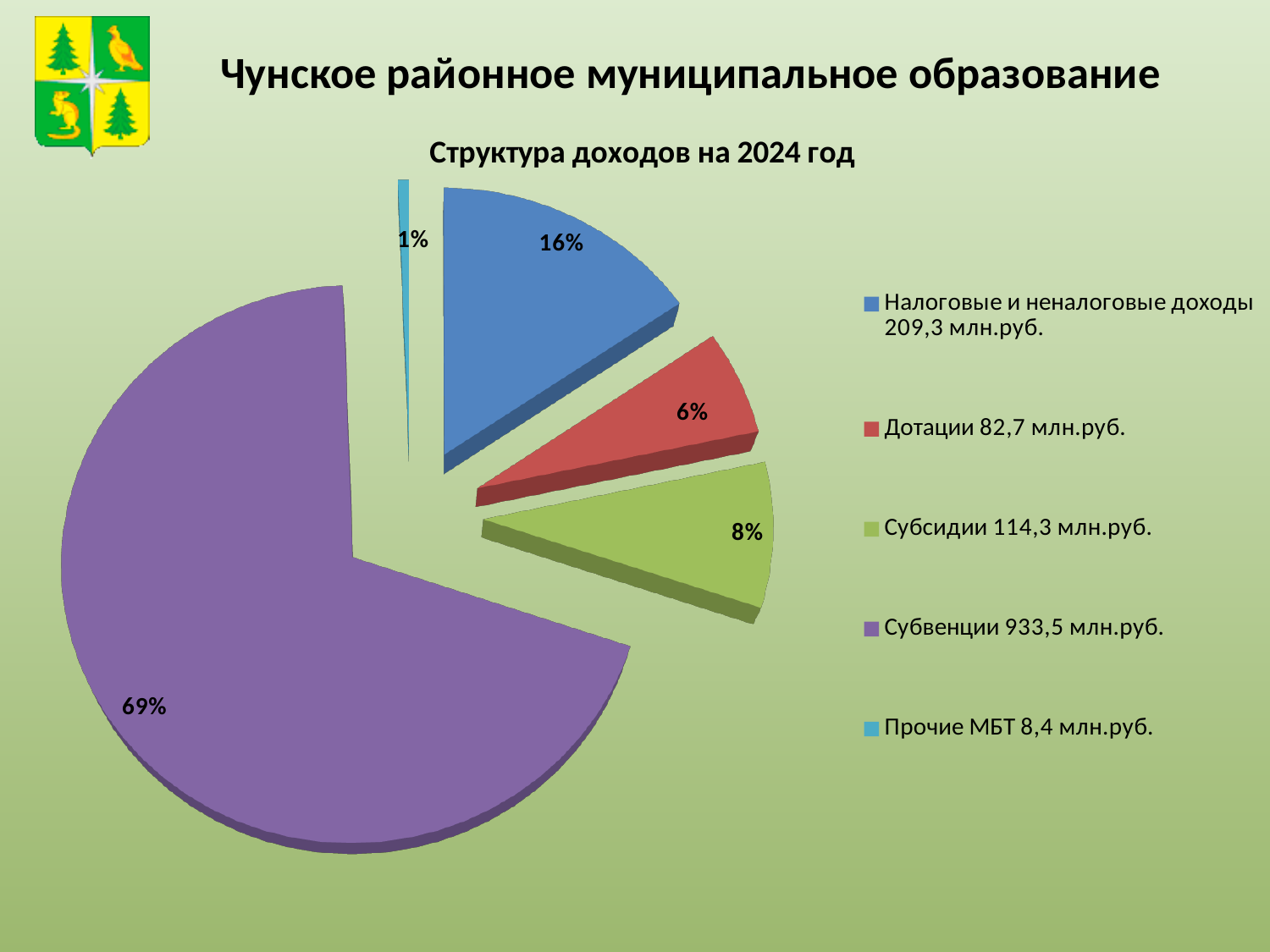
What share of the pie does Налоговые и неналоговые доходы take? 16% What share of the pie does Субсидии take? 8% What share of the pie does Субвенции take? 69% Which category has the largest slice of the pie? Субвенции Which category has the smallest slice of the pie? Прочие МБТ What amount in млн.руб. is shown in the legend for Субвенции? 933,5 млн.руб. What kind of chart is shown on the slide? Pie chart Which is larger, the share for Субсидии or the share for Дотации? Субсидии What is the title of the chart? Структура доходов на 2024 год How many slices does the pie chart have? 5